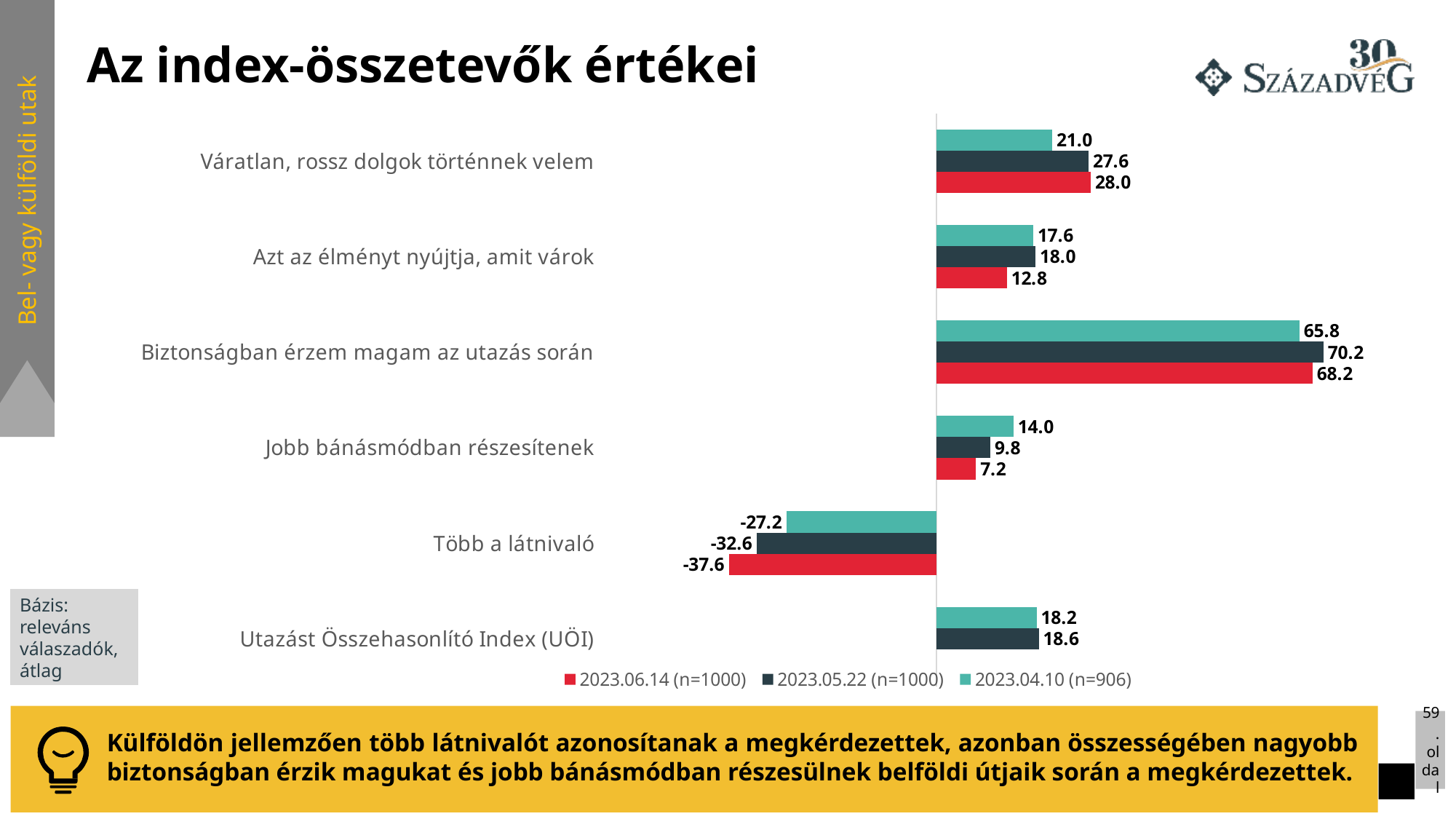
How many categories are shown on the chart? 6 Which category has the highest value in the 2023.06.14 (n=1000) series? Biztonságban érzem magam az utazás során What kind of chart is shown on the slide? Bar chart What is the difference between the 2023.06.14 (n=1000) and 2023.04.10 (n=906) values for "Váratlan, rossz dolgok történnek velem"? 7.0 For "Jobb bánásmódban részesítenek", which series has the larger value: 2023.05.22 (n=1000) or 2023.06.14 (n=1000)? 2023.05.22 (n=1000) How many series does the legend list? 3 What is the value for "Biztonságban érzem magam az utazás során" in the 2023.05.22 (n=1000) series? 70.2 What is the value for "Több a látnivaló" in the 2023.06.14 (n=1000) series? -37.6 Which category has the lowest value in the 2023.04.10 (n=906) series? Több a látnivaló What is the value for "Azt az élményt nyújtja, amit várok" in the 2023.06.14 (n=1000) series? 12.8 What is the title of the slide? Az index-összetevők értékei What is the value for "Jobb bánásmódban részesítenek" in the 2023.04.10 (n=906) series? 14.0